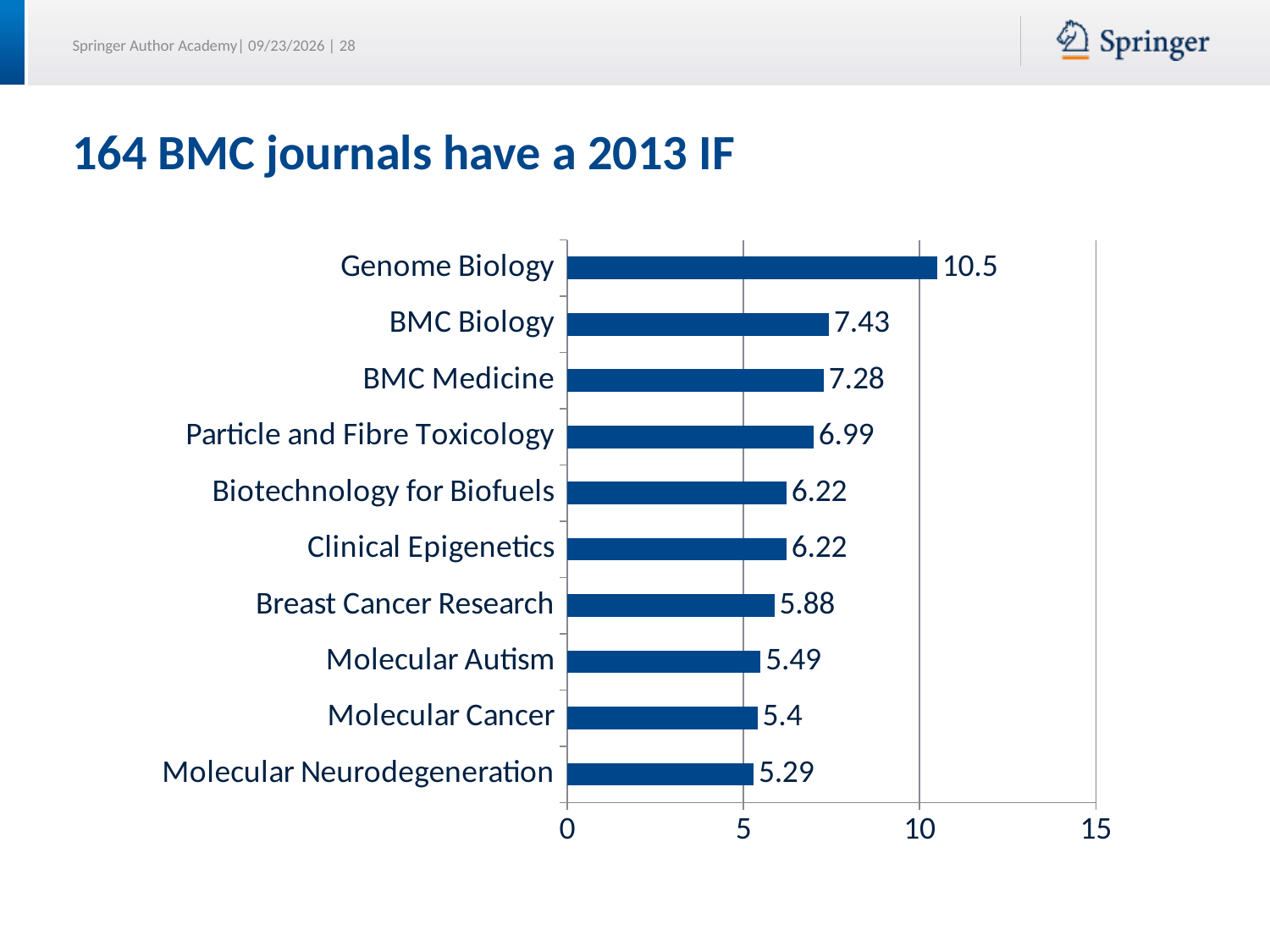
Which journal has the highest value in the chart? Genome Biology What is the difference between the values for Genome Biology and BMC Biology? 3.07 What value is shown for Molecular Autism? 5.49 Which has a larger value, Particle and Fibre Toxicology or Biotechnology for Biofuels? Particle and Fibre Toxicology Is the value for Genome Biology greater or less than 10? greater What is the difference between the values for Breast Cancer Research and Molecular Cancer? 0.48 How many journals are shown in the chart? 10 What is the 2013 impact factor shown for Genome Biology? 10.5 Which journal has the lowest value in the chart? Molecular Neurodegeneration What is the title of the slide? 164 BMC journals have a 2013 IF What value is shown for BMC Medicine? 7.28 What kind of chart is shown on the slide? bar chart